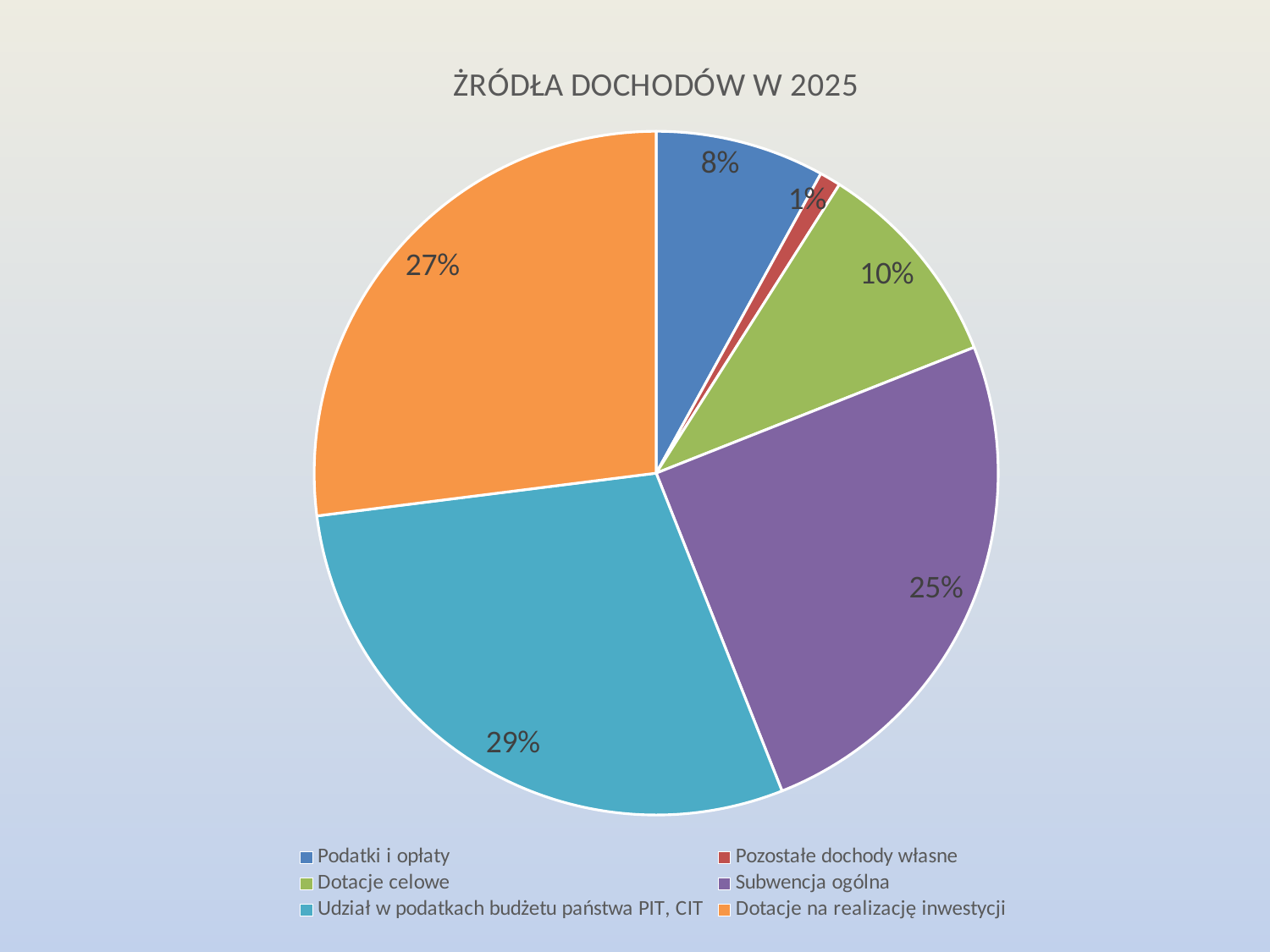
What share of the pie does Podatki i opłaty have? 8% What kind of chart is shown on the slide? pie chart Which category has the smallest share of the pie? Pozostałe dochody własne What is the difference in percentage points between Udział w podatkach budżetu państwa PIT, CIT and Subwencja ogólna? 4 What share of the pie does Udział w podatkach budżetu państwa PIT, CIT have? 29% How many categories does the pie chart have? 6 Which category has the largest share of the pie? Udział w podatkach budżetu państwa PIT, CIT Which is larger, the share for Dotacje celowe or the share for Podatki i opłaty? Dotacje celowe What is the title of the chart? ŻRÓDŁA DOCHODÓW W 2025 What share of the pie does Subwencja ogólna have? 25%